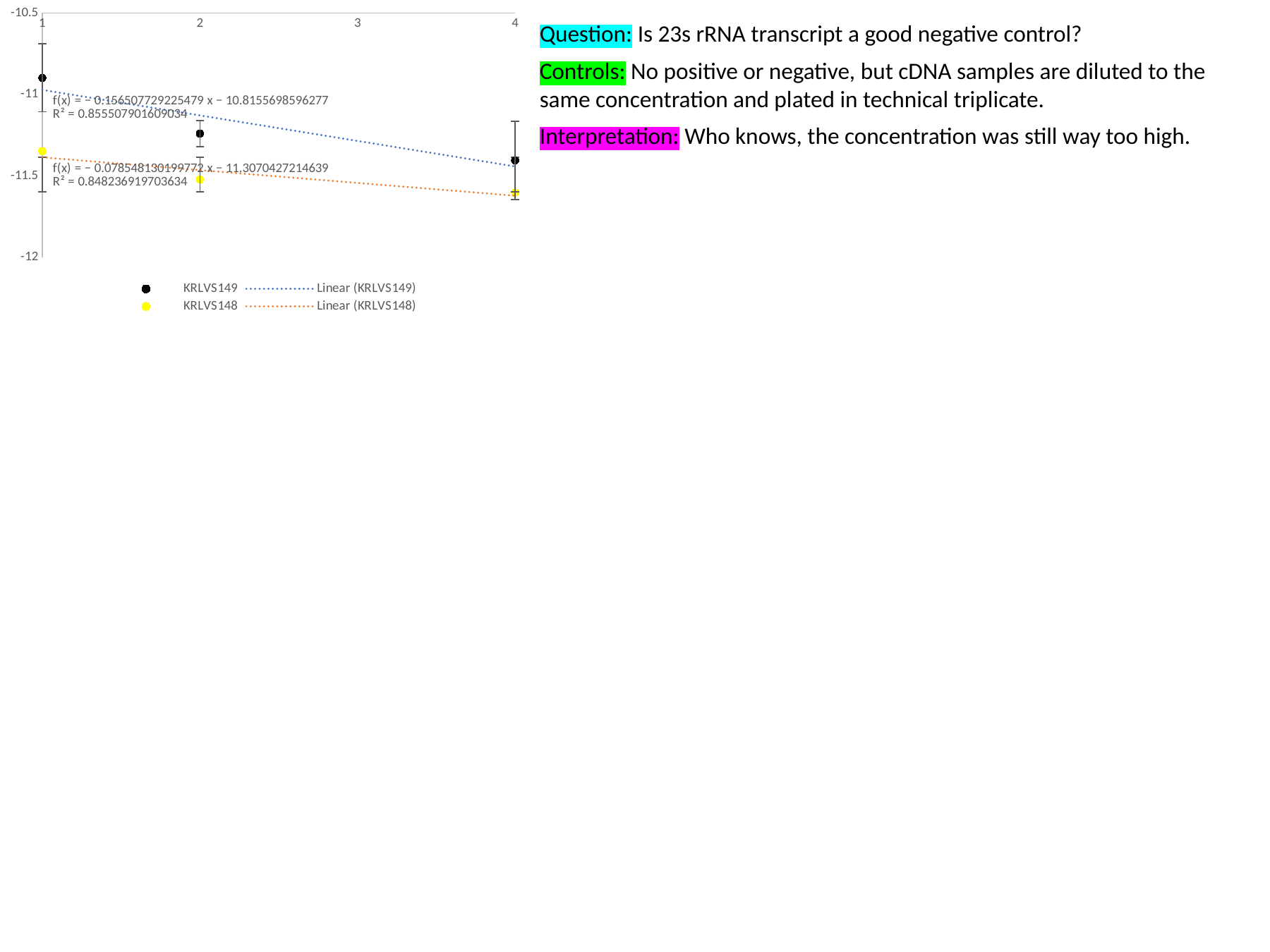
How many entries does the chart legend list? 4 Is the KRLVS148 value at x = 4 greater or less than -11.5? less At x = 4, which series has the higher value, KRLVS149 or KRLVS148? KRLVS149 Do the KRLVS149 values rise or fall as x increases from 1 to 4? fall At x = 1, which series has the higher value, KRLVS149 or KRLVS148? KRLVS149 How many data points are plotted for the KRLVS149 series? 3 What is the R² value shown for the Linear (KRLVS148) trendline? 0.848236919703634 What is the R² value shown for the Linear (KRLVS149) trendline? 0.855507901609034 What kind of chart is shown on the slide? scatter chart Is the KRLVS149 value at x = 1 greater or less than -11? greater Is the KRLVS148 value at x = 1 greater or less than -11? less What colour are the markers for the KRLVS148 series? yellow